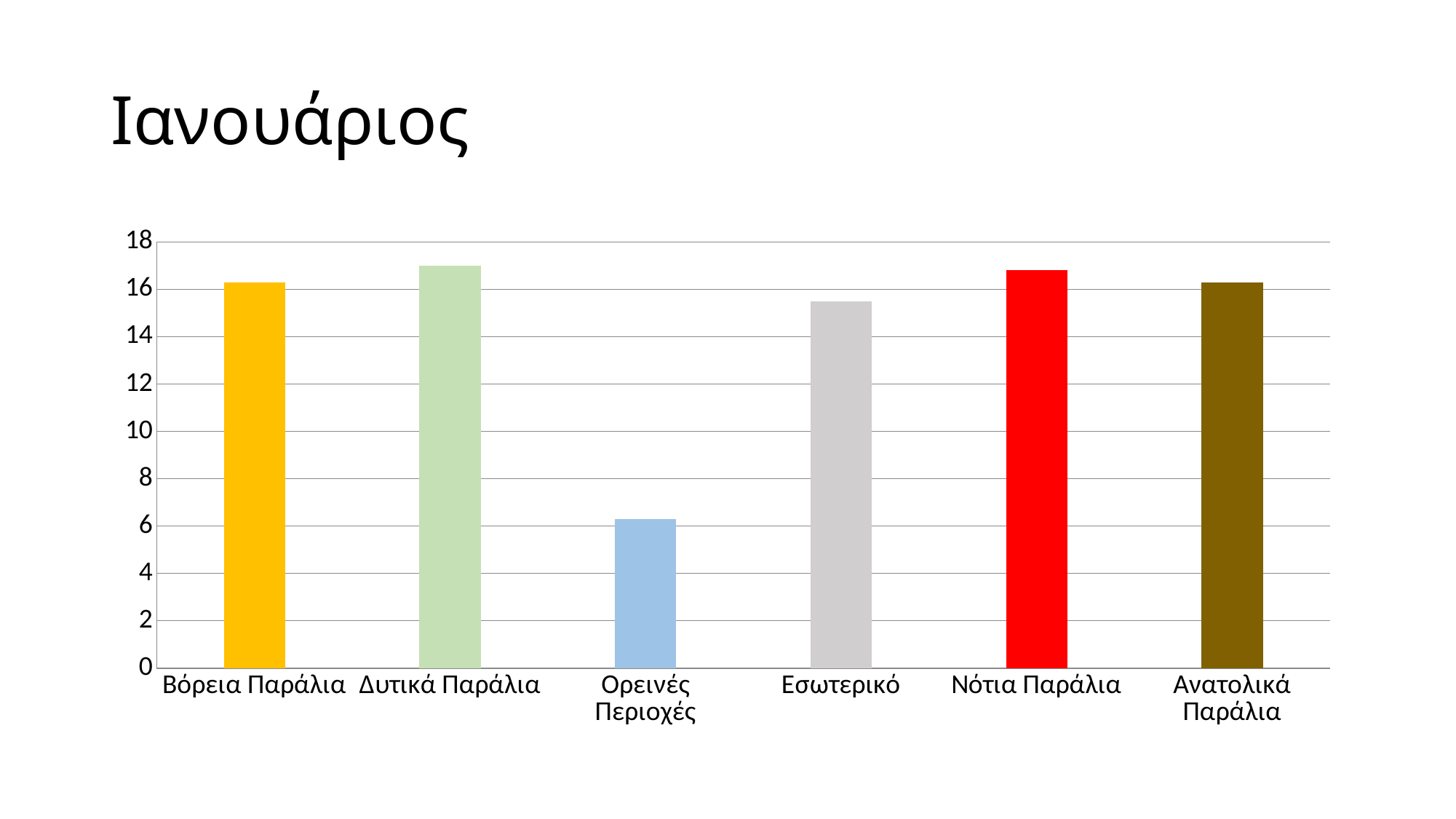
Is the value for Βόρεια Παράλια greater or less than 12? greater Is the value for Δυτικά Παράλια greater or less than 16? greater How many categories are shown on the x axis of the chart? 6 Is the value for Εσωτερικό greater or less than 14? greater What kind of chart is shown on the slide? Bar chart What is the title of the chart on the slide? Ιανουάριος Which category has the lowest value in the chart? Ορεινές Περιοχές Which is larger, the value for Ορεινές Περιοχές or the value for Ανατολικά Παράλια? Ανατολικά Παράλια What colour is the bar for Νότια Παράλια? Red Which is larger, the value for Δυτικά Παράλια or the value for Εσωτερικό? Δυτικά Παράλια